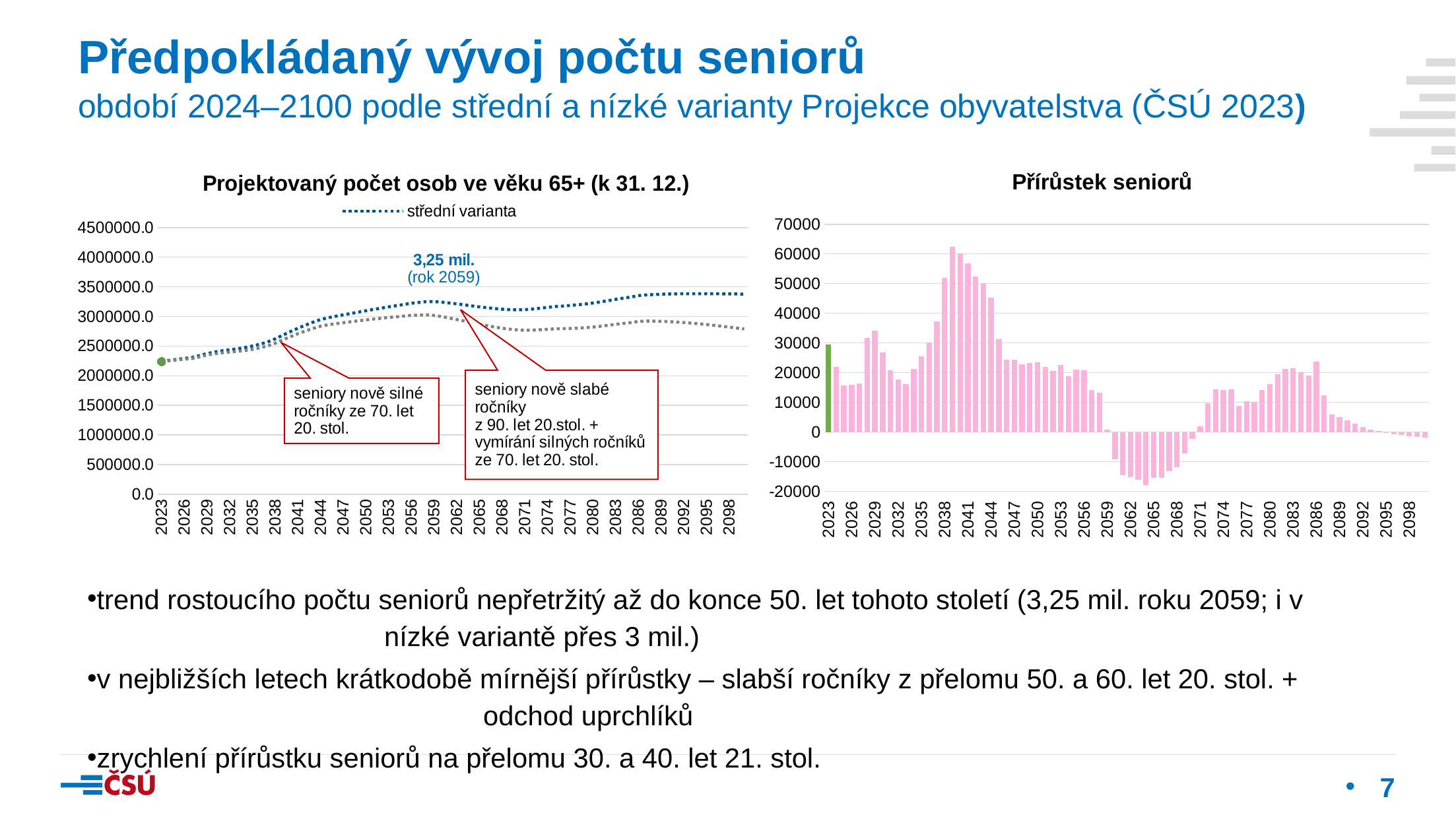
What kind of chart is the right chart titled 'Přírůstek seniorů'? bar chart In the left chart 'Projektovaný počet osob ve věku 65+', what series name does the legend show? střední varianta In the right chart 'Přírůstek seniorů', is the value for 2040 greater or less than 50000? greater In the left chart 'Projektovaný počet osob ve věku 65+', in which year does the annotated peak of 3,25 mil. occur? 2059 In the right chart 'Přírůstek seniorů', do the values rise or fall between 2059 and 2065? fall In the left chart 'Projektovaný počet osob ve věku 65+', is the střední varianta value for 2023 greater or less than 2500000.0? less In the right chart 'Přírůstek seniorů', is the value for 2065 greater or less than -10000? less What kind of chart is the left chart titled 'Projektovaný počet osob ve věku 65+ (k 31. 12.)'? line chart In the left chart 'Projektovaný počet osob ve věku 65+', does the střední varianta line rise or fall between 2023 and 2059? rise In the left chart 'Projektovaný počet osob ve věku 65+', what peak value is annotated on the střední varianta line? 3,25 mil. In the right chart 'Přírůstek seniorů', which year has the larger value, 2040 or 2080? 2040